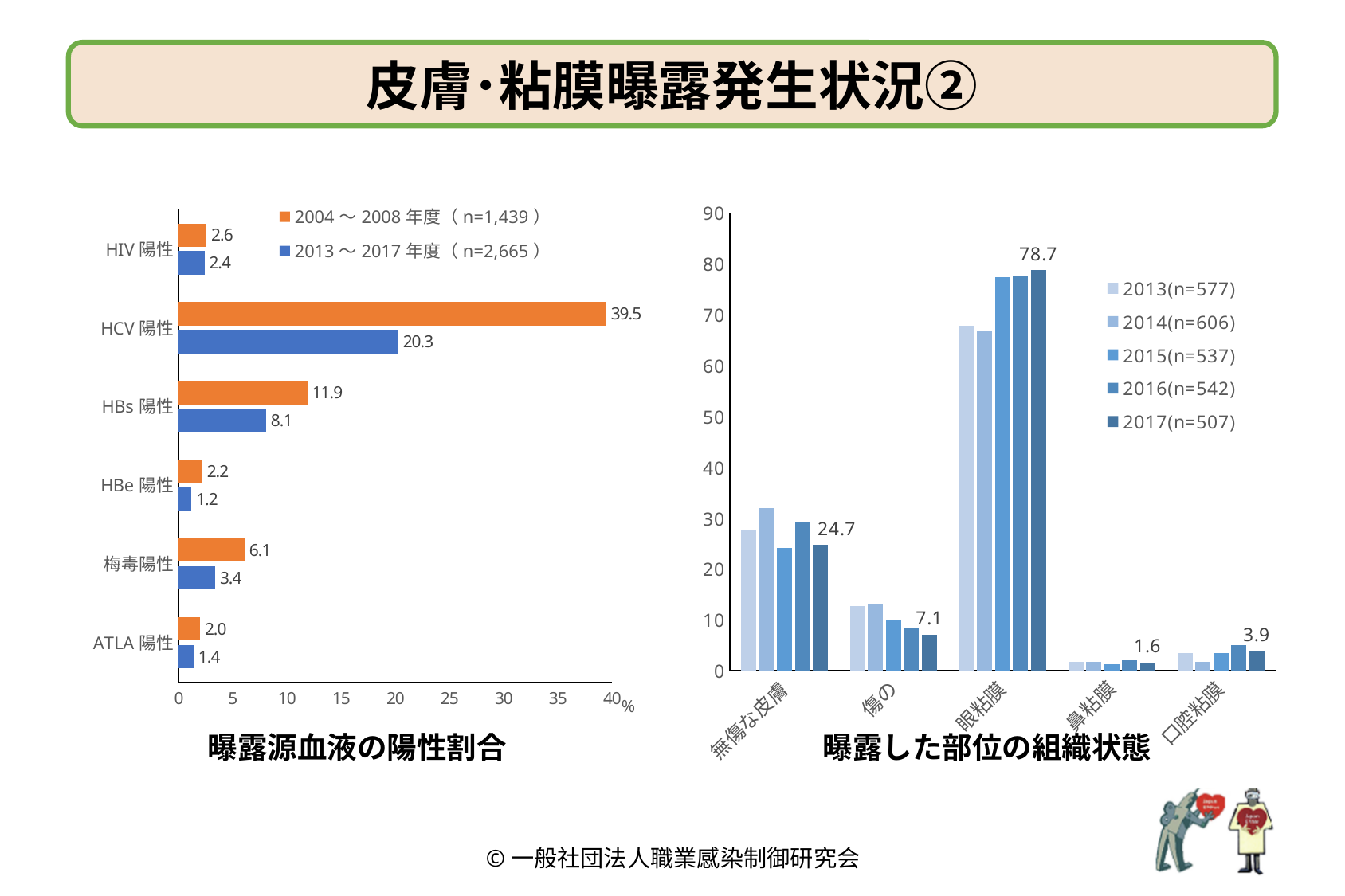
In the chart titled 曝露源血液の陽性割合, what is the value for 梅毒陽性 in the 2013～2017年度 series? 3.4 In the chart titled 曝露源血液の陽性割合, what is the value for HCV 陽性 in the 2004～2008年度 series? 39.5 In the chart titled 曝露した部位の組織状態, what is the labeled value for 眼粘膜 in the 2017 series? 78.7 In the chart titled 曝露した部位の組織状態, how many series does the legend list? 5 What kind of chart is the chart titled 曝露した部位の組織状態? bar chart In the chart titled 曝露源血液の陽性割合, what is the difference between the 2004～2008年度 and 2013～2017年度 values for HBs 陽性? 3.8 In the chart titled 曝露源血液の陽性割合, which category has the highest value in the 2013～2017年度 series? HCV 陽性 In the chart titled 曝露源血液の陽性割合, which category has the lowest value in the 2004～2008年度 series? ATLA 陽性 In the chart titled 曝露した部位の組織状態, what is the labeled value for 鼻粘膜 in the 2017 series? 1.6 In the chart titled 曝露源血液の陽性割合, how many series does the legend list? 2 In the chart titled 曝露源血液の陽性割合, how many categories are shown on the vertical axis? 6 In the chart titled 曝露した部位の組織状態, is the value for 無傷な皮膚 in the 2013 series greater or less than 20? greater